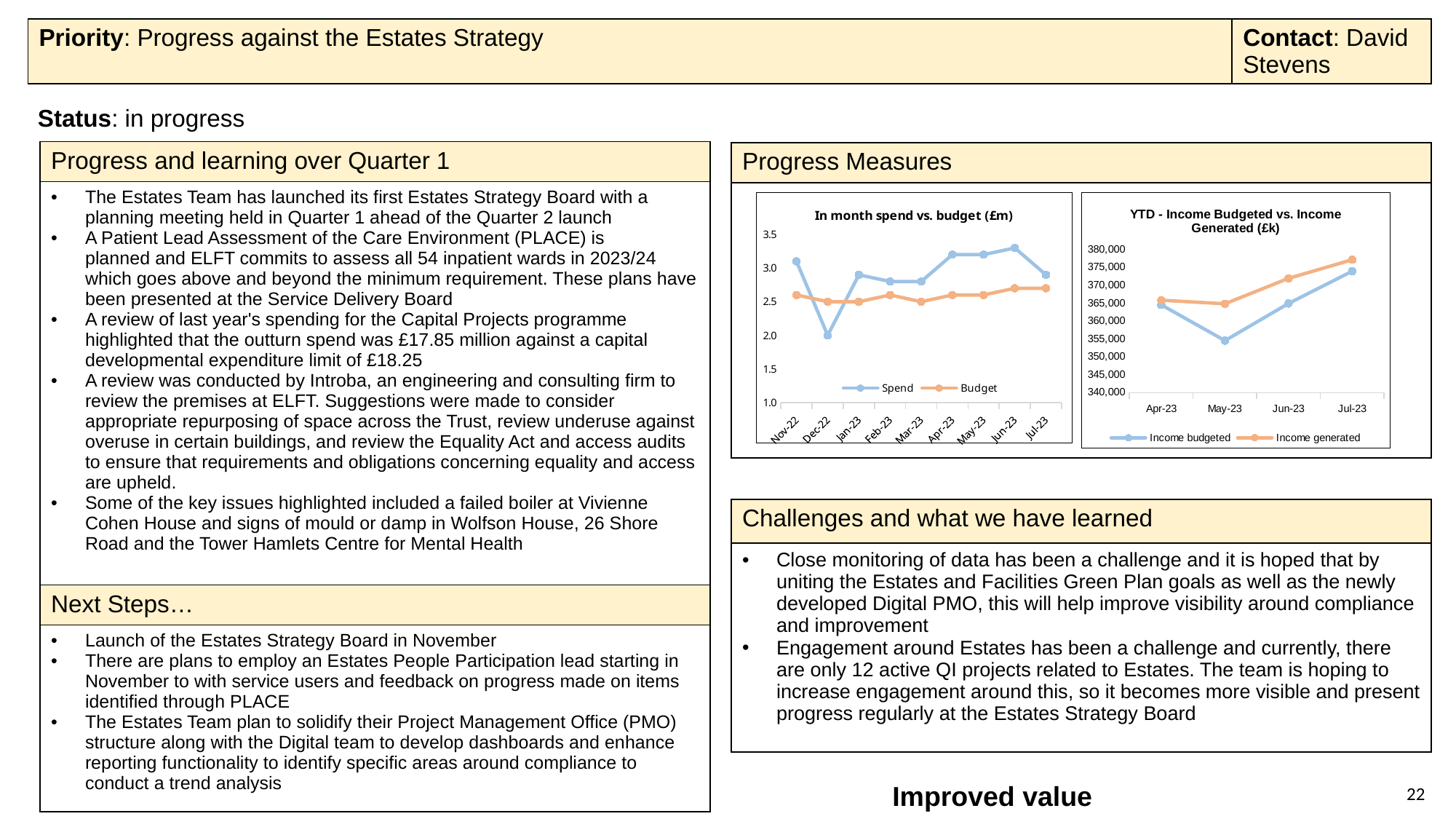
How many months are plotted on the x axis of the 'YTD - Income Budgeted vs. Income Generated (£k)' chart? 4 In the 'YTD - Income Budgeted vs. Income Generated (£k)' chart, does Income generated rise or fall from May-23 to Jul-23? rise In the 'In month spend vs. budget (£m)' chart, is the Spend value for Dec-22 greater or less than 2.5? less In the 'YTD - Income Budgeted vs. Income Generated (£k)' chart, in which month is Income budgeted lowest? May-23 What kind of chart is the 'In month spend vs. budget (£m)' chart? line chart How many months are plotted on the x axis of the 'In month spend vs. budget (£m)' chart? 9 In the 'In month spend vs. budget (£m)' chart, which is larger in Dec-22, Spend or Budget? Budget In the 'In month spend vs. budget (£m)' chart, in which month is Spend lowest? Dec-22 How many series does the legend of the 'In month spend vs. budget (£m)' chart list? 2 In the 'YTD - Income Budgeted vs. Income Generated (£k)' chart, is the Income budgeted value for May-23 greater or less than 360,000? less In the 'In month spend vs. budget (£m)' chart, which is larger in Jun-23, Spend or Budget? Spend How many series does the legend of the 'YTD - Income Budgeted vs. Income Generated (£k)' chart list? 2